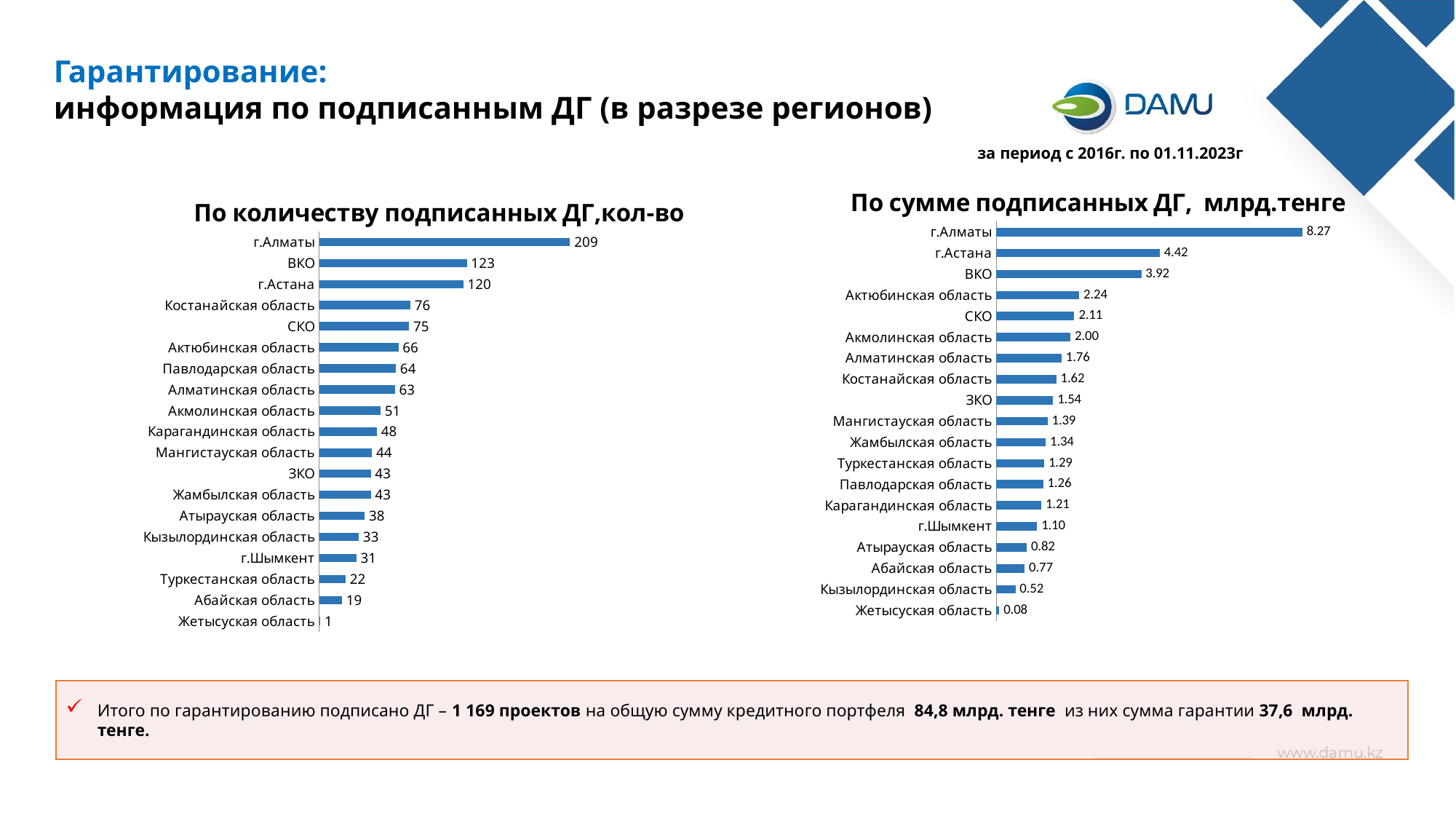
In the chart 'По сумме подписанных ДГ, млрд.тенге', which is larger: г.Астана or ВКО? г.Астана In the chart 'По количеству подписанных ДГ,кол-во', what is the value for г.Шымкент? 31 In the chart 'По количеству подписанных ДГ,кол-во', which region has the highest value? г.Алматы In the chart 'По количеству подписанных ДГ,кол-во', which region has the lowest value? Жетысуская область In the chart 'По сумме подписанных ДГ, млрд.тенге', what is the value for Актюбинская область? 2.24 In the chart 'По количеству подписанных ДГ,кол-во', how many regions are shown? 19 In the chart 'По сумме подписанных ДГ, млрд.тенге', which region has the lowest value? Жетысуская область In the chart 'По сумме подписанных ДГ, млрд.тенге', which region has the highest value? г.Алматы What type of chart is 'По сумме подписанных ДГ, млрд.тенге'? Bar chart In the chart 'По количеству подписанных ДГ,кол-во', what is the difference between г.Алматы and г.Астана? 89 In the chart 'По количеству подписанных ДГ,кол-во', what is the value for ВКО? 123 In the chart 'По сумме подписанных ДГ, млрд.тенге', what is the difference between г.Алматы and г.Астана? 3.85